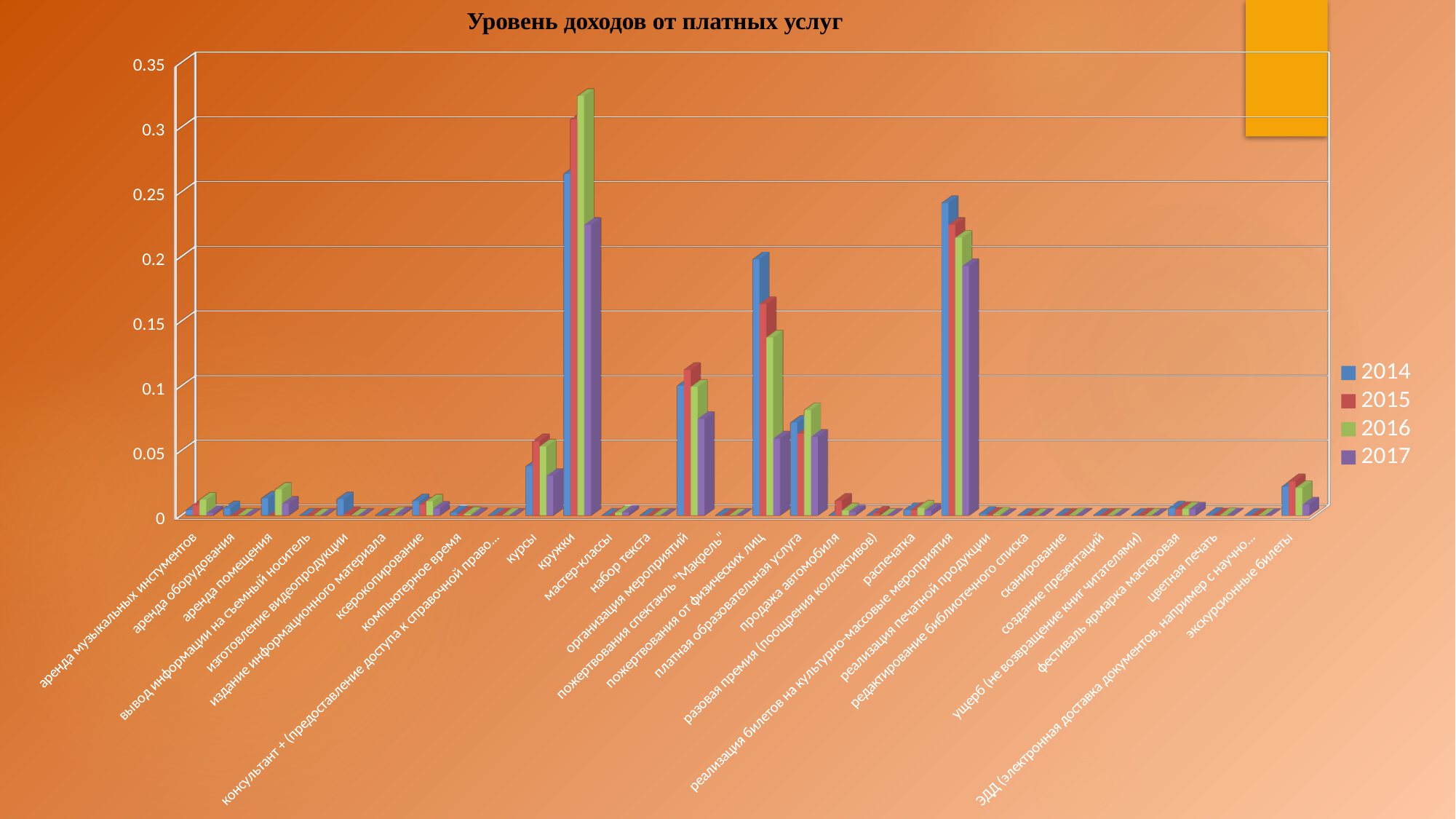
Is the 2014 value for реализация билетов на культурно-массовые мероприятия greater or less than 0.2? greater For пожертвования от физических лиц, do the values rise or fall from 2014 to 2017? fall What kind of chart is shown on the slide? bar chart Is the 2016 value for кружки greater or less than 0.3? greater For реализация билетов на культурно-массовые мероприятия, which is larger: the 2014 value or the 2017 value? 2014 Is the 2015 value for организация мероприятий greater or less than 0.15? less Which series has the lowest value for кружки? 2017 What is the title of the chart? Уровень доходов от платных услуг Which category has the highest value for the 2016 series? кружки How many series does the legend list? 4 For кружки, which is larger: the 2016 value or the 2017 value? 2016